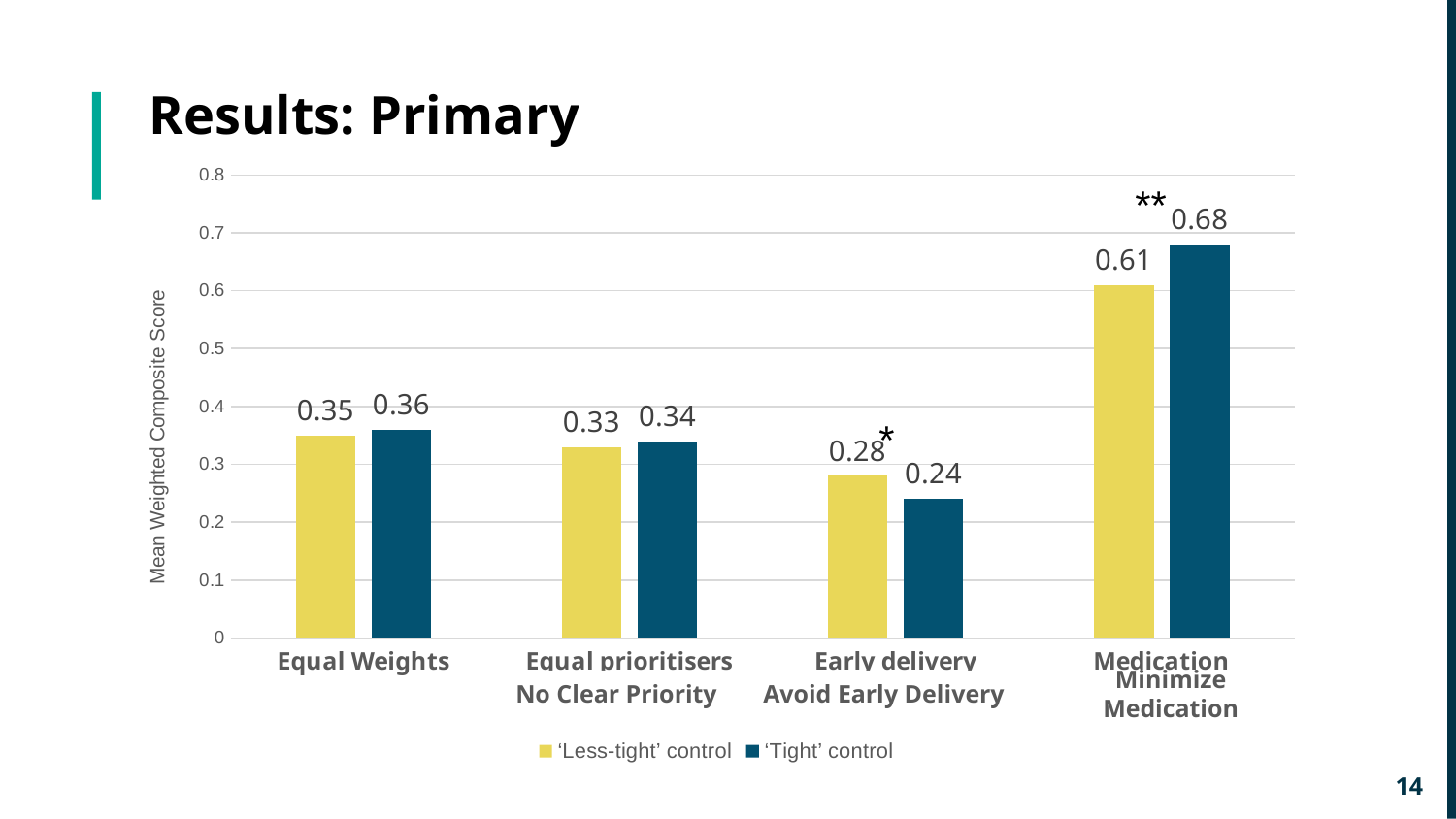
How many categories are shown on the x axis? 4 What is the 'Less-tight' control value for Equal Weights? 0.35 Which category has the highest 'Tight' control value? Minimize Medication What is the 'Tight' control value for Minimize Medication? 0.68 What is the 'Less-tight' control value for No Clear Priority? 0.33 Is the 'Less-tight' control value for Minimize Medication greater or less than 0.5? greater What is the 'Tight' control value for Avoid Early Delivery? 0.24 For Avoid Early Delivery, which is larger: the 'Less-tight' control value or the 'Tight' control value? 'Less-tight' control Which category has the lowest 'Less-tight' control value? Avoid Early Delivery What kind of chart is shown on the slide? bar chart What is the difference between the 'Tight' control and 'Less-tight' control values for Minimize Medication? 0.07 How many series does the legend list? 2